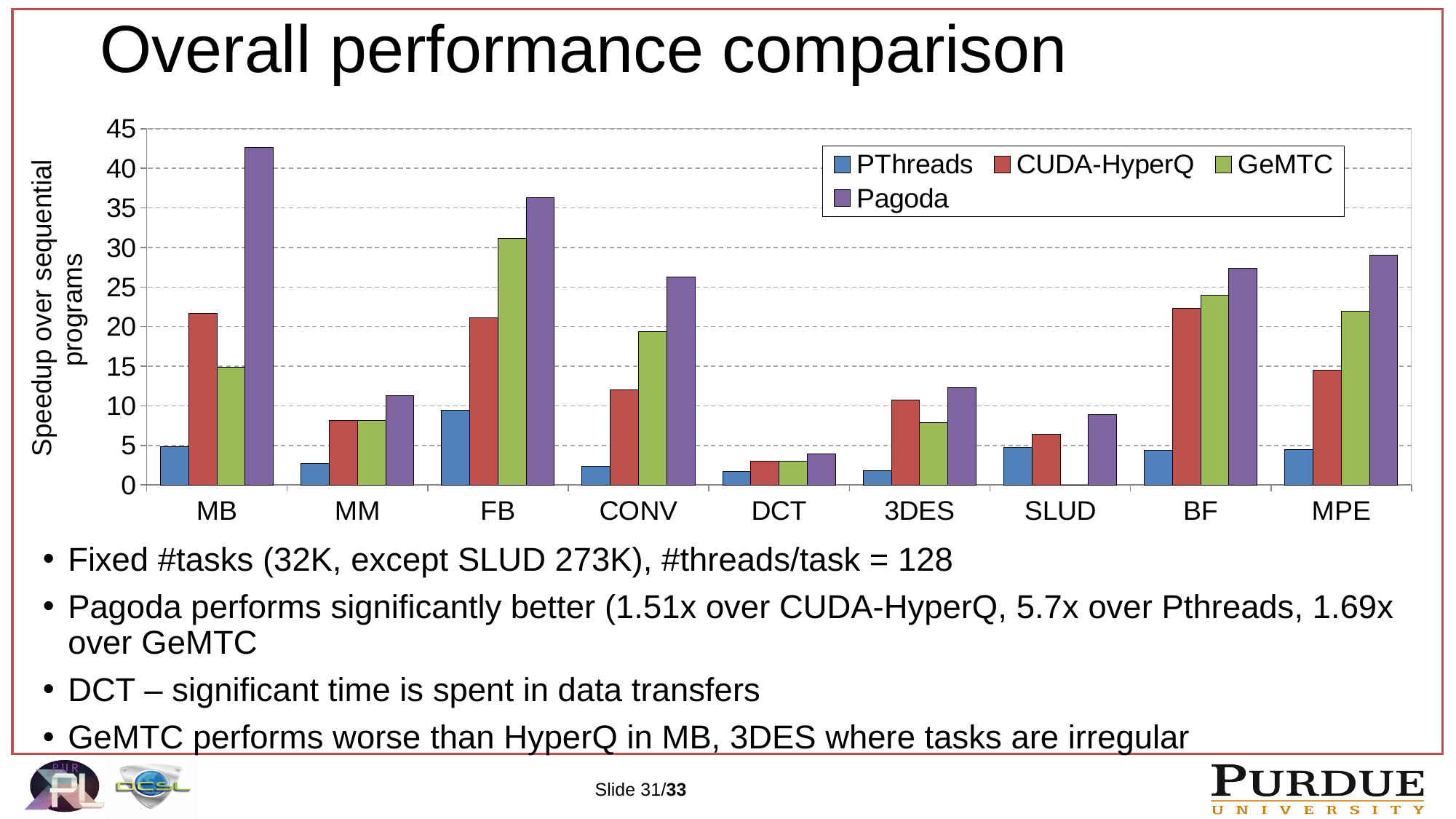
What is the title of the chart's y axis? Speedup over sequential programs For MB, which series has the highest speedup? Pagoda For 3DES, which is larger: the CUDA-HyperQ value or the GeMTC value? CUDA-HyperQ For FB, which is larger: the GeMTC value or the CUDA-HyperQ value? GeMTC How many series does the chart's legend list? 4 Is the CUDA-HyperQ value for CONV greater or less than 10? greater How many benchmarks (categories) are shown on the x axis of the chart? 9 Which benchmark has the highest Pagoda speedup? MB Which benchmark has the lowest Pagoda speedup? DCT Is the Pagoda value for MB greater or less than 40? greater What kind of chart is shown on the slide? bar chart Is the GeMTC value for FB greater or less than 30? greater